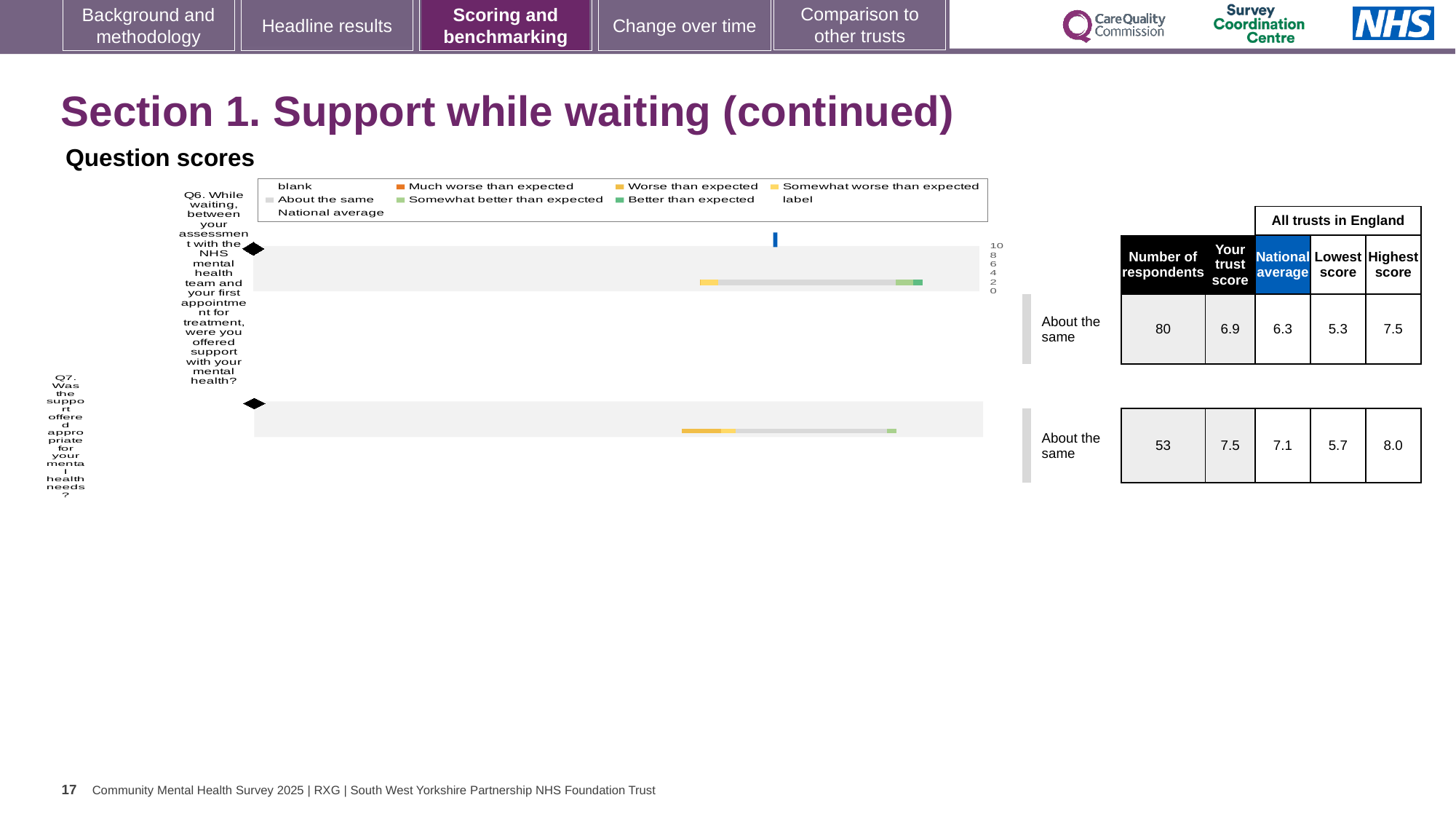
How many respondents answered Q6? 80 Which question has the higher trust score, Q6 or Q7? Q7 What benchmark category is shown for Q6? About the same What kind of chart is used to show the question scores on this slide? bar chart What is the trust score for Q7 (was the support offered appropriate)? 7.5 What is the difference between the trust score and the national average for Q6? 0.6 How many questions (Q6 and Q7) are plotted on the slide? 2 What is the trust score for Q6 (support with mental health while waiting)? 6.9 How many respondents answered Q7? 53 What is the national average score for Q6? 6.3 What is the highest score among all trusts in England for Q7? 8.0 What is the national average score for Q7? 7.1